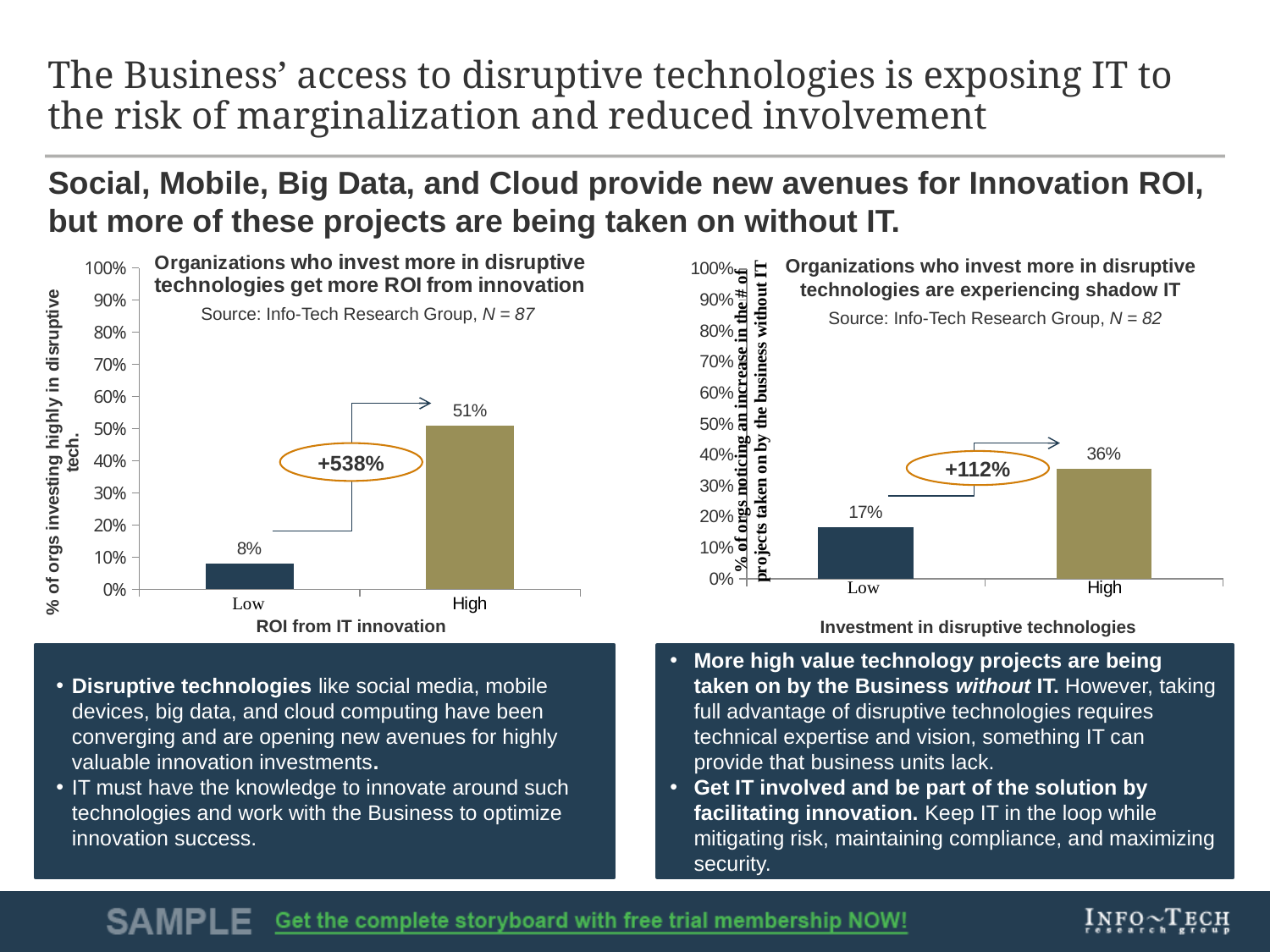
What is the x-axis title of the right chart? Investment in disruptive technologies In the left chart, which category has the highest value? High In the left chart (Organizations who invest more in disruptive technologies get more ROI from innovation), what is the value for the Low category? 8% In the right chart (Organizations who invest more in disruptive technologies are experiencing shadow IT), what is the value for the Low category? 17% In the left chart, what is the difference between the High and Low values? 43% In the right chart, which category has the lowest value? Low In the right chart (Organizations who invest more in disruptive technologies are experiencing shadow IT), what is the value for the High category? 36% How many categories are shown on the x axis of the left chart? 2 In the right chart, is the value for High greater or less than 30%? greater What type of chart is the right chart? Bar chart In the left chart (Organizations who invest more in disruptive technologies get more ROI from innovation), what is the value for the High category? 51% In the right chart, what is the difference between the High and Low values? 19%